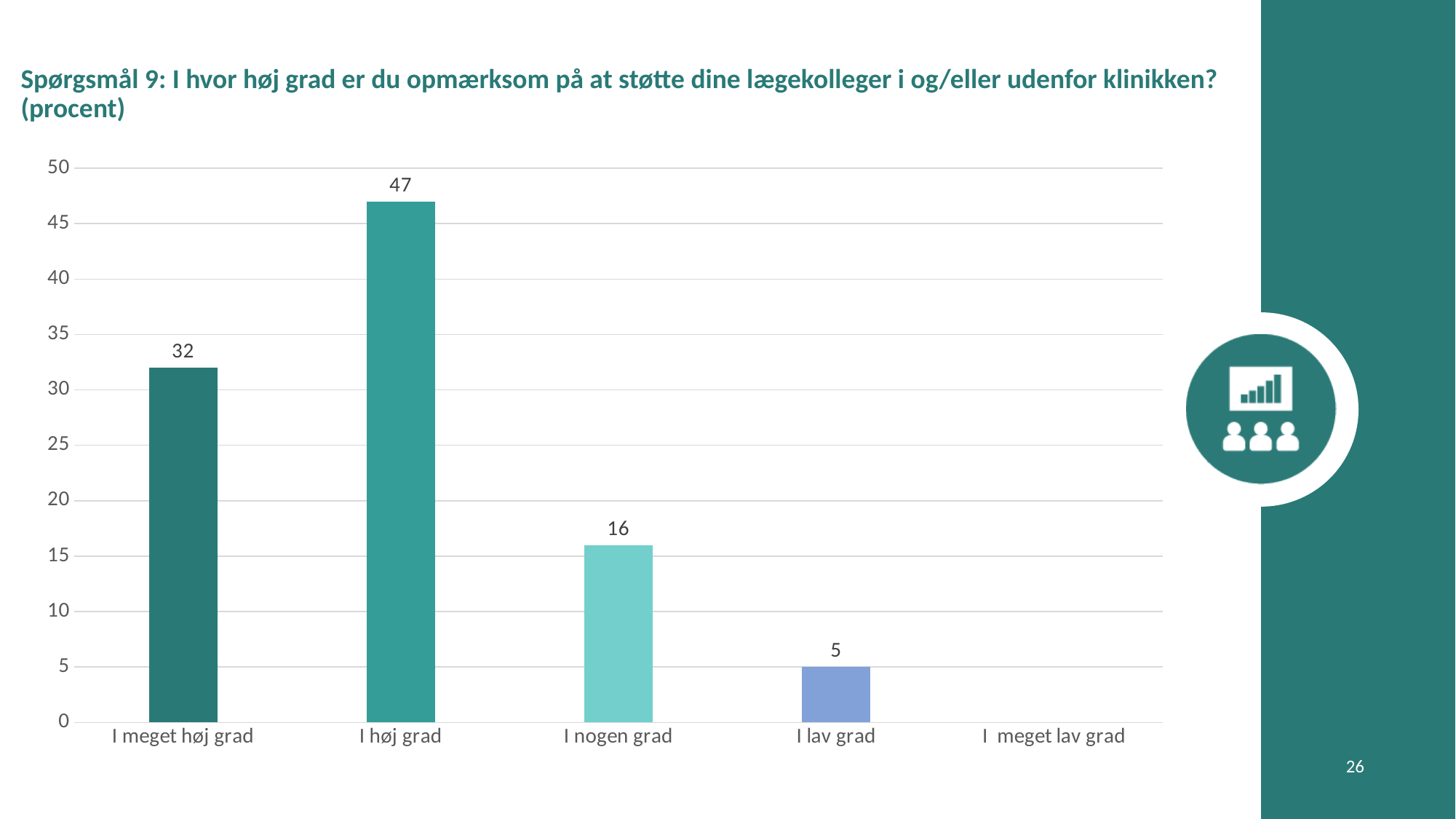
What is the value for "I høj grad"? 47 What is the value for "I lav grad"? 5 How many categories are shown on the x axis? 5 What kind of chart is shown on the slide? bar chart Which category with a visible bar has the lowest value? I lav grad Is the value for "I meget høj grad" greater or less than 30? greater What is the value for "I meget høj grad"? 32 What is the difference between the values for "I høj grad" and "I meget høj grad"? 15 What is the value for "I nogen grad"? 16 Which is larger, the value for "I nogen grad" or the value for "I lav grad"? I nogen grad Which category has the highest value? I høj grad What is the maximum value shown on the y axis? 50